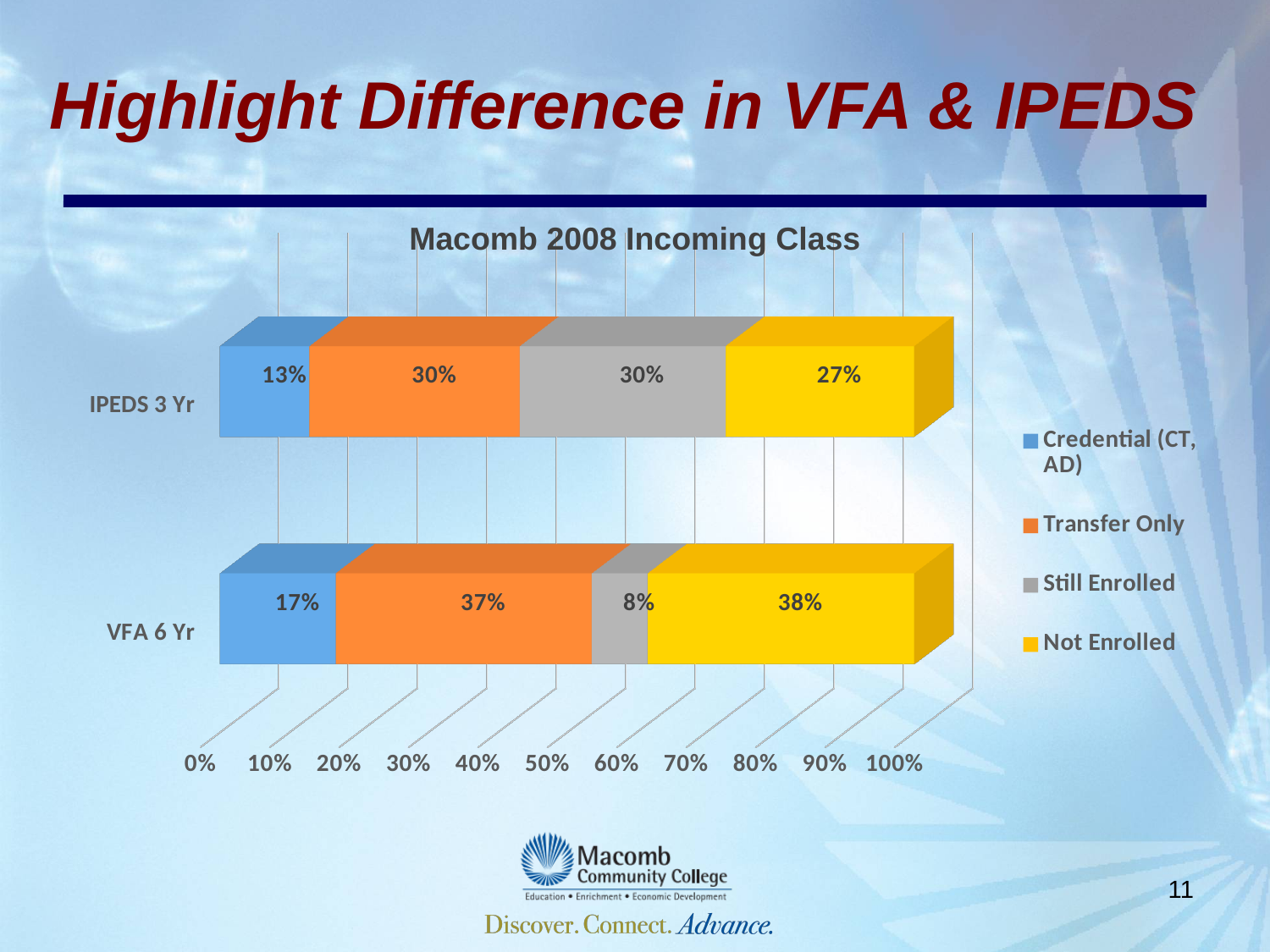
How many categories are shown on the chart? 2 How many series does the legend list? 4 Which segment is the largest in the VFA 6 Yr bar? Not Enrolled What is the Still Enrolled value for VFA 6 Yr? 8% What is the difference between the Not Enrolled values for VFA 6 Yr and IPEDS 3 Yr? 11% What is the difference between the Transfer Only values for VFA 6 Yr and IPEDS 3 Yr? 7% What is the Not Enrolled value for IPEDS 3 Yr? 27% What is the title of the chart? Macomb 2008 Incoming Class What is the Transfer Only value for VFA 6 Yr? 37% Which segment is the smallest in the IPEDS 3 Yr bar? Credential (CT, AD) Which category has the higher Still Enrolled value, IPEDS 3 Yr or VFA 6 Yr? IPEDS 3 Yr What is the Credential (CT, AD) value for IPEDS 3 Yr? 13%